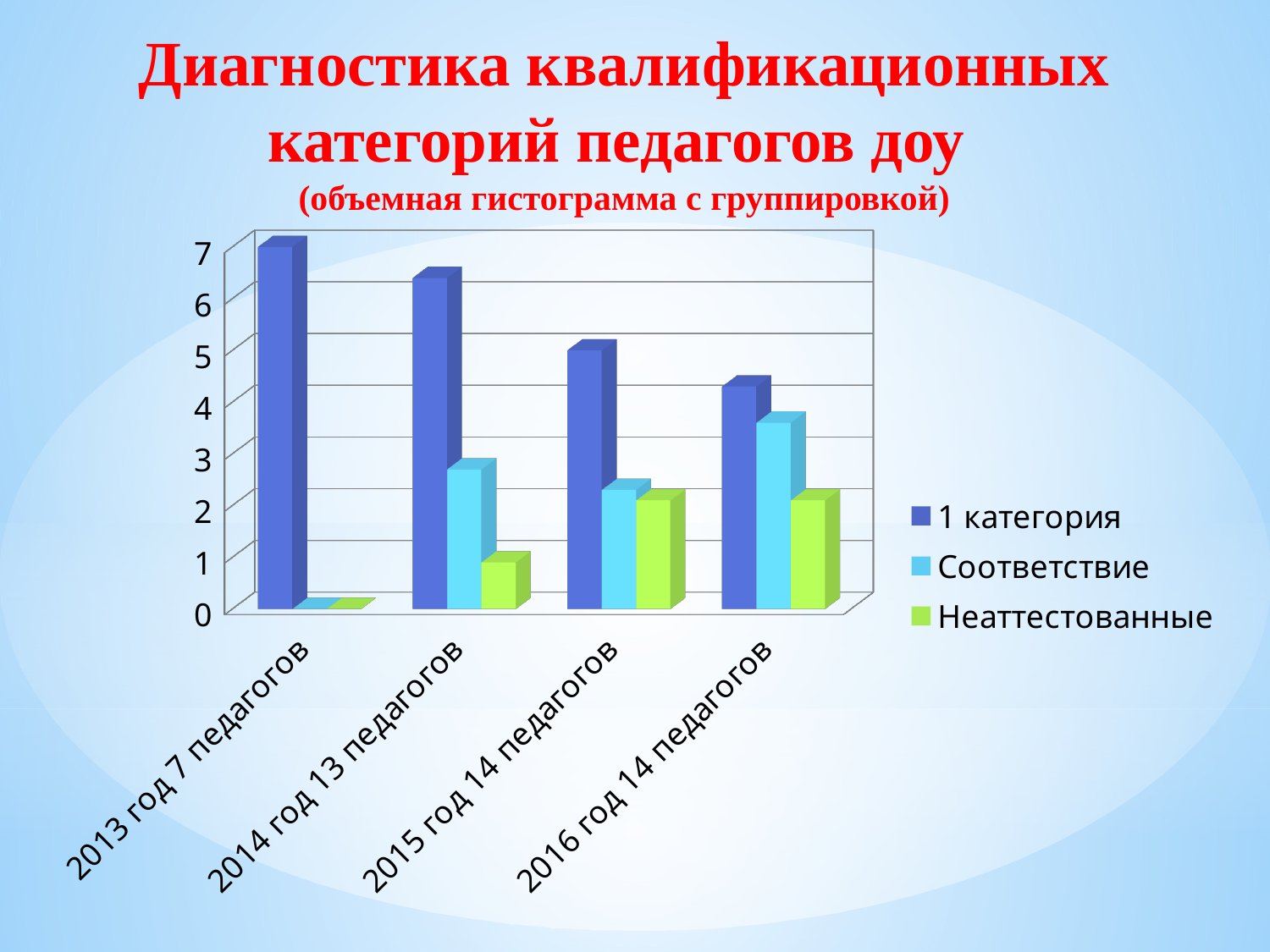
What is the subtitle in parentheses under the chart title? (объемная гистограмма с группировкой) Is the value for "Неаттестованные" in "2014 год 13 педагогов" greater or less than 2? less In which year category is the value for "1 категория" highest? 2013 год 7 педагогов How many series does the legend list? 3 Is the value for "1 категория" in "2013 год 7 педагогов" greater or less than 6? greater What kind of chart is shown on the slide? bar chart Is the value for "Соответствие" in "2016 год 14 педагогов" greater or less than 3? greater Does the value for "1 категория" rise or fall from 2013 to 2016? fall In which year category is the value for "1 категория" lowest? 2016 год 14 педагогов In "2014 год 13 педагогов", which is larger: "1 категория" or "Соответствие"? 1 категория Which series is shown in green in the legend? Неаттестованные How many year categories are shown on the x axis? 4